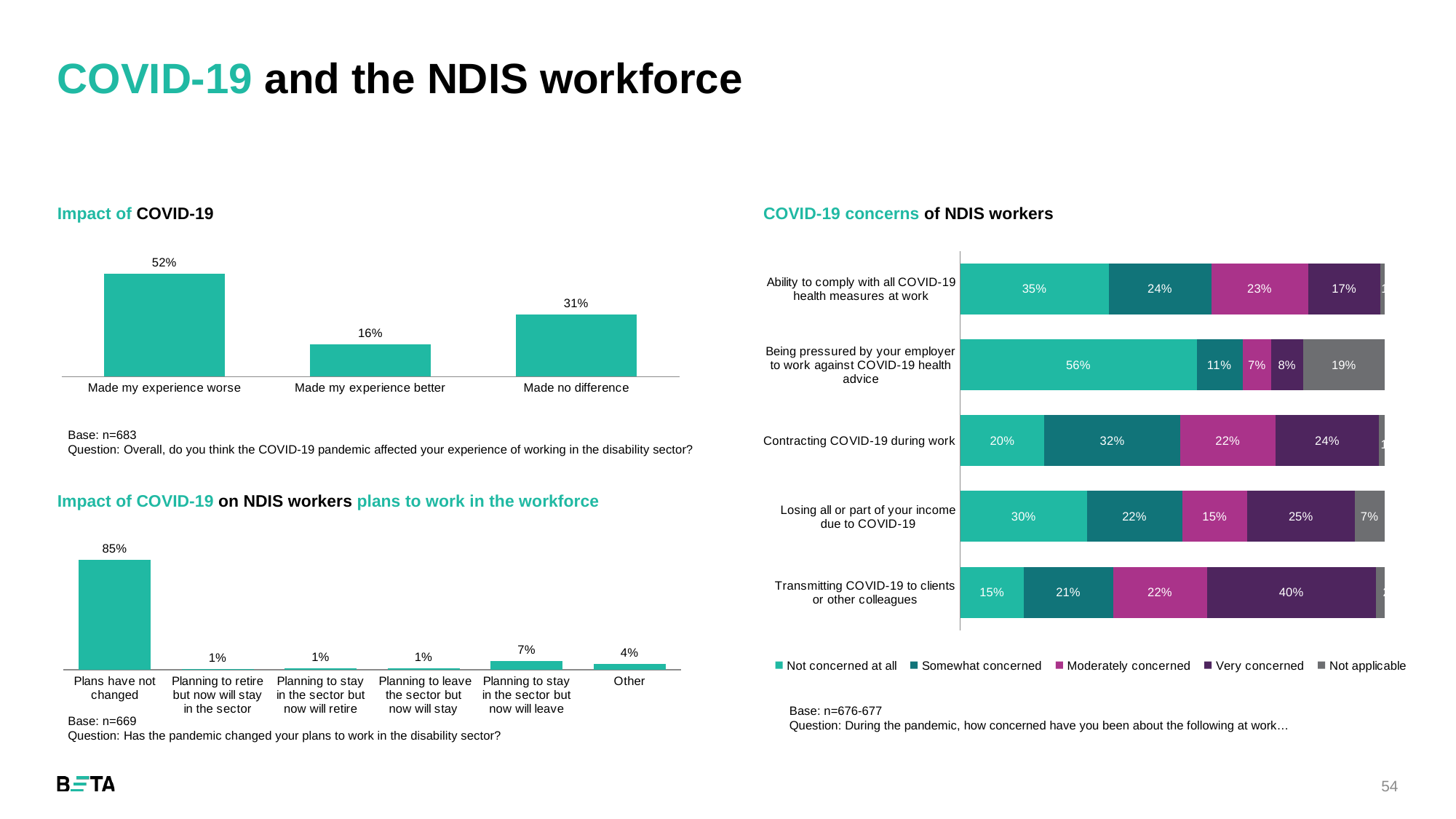
In the 'COVID-19 concerns of NDIS workers' chart, what is the difference between the 'Somewhat concerned' values for 'Contracting COVID-19 during work' and 'Losing all or part of your income due to COVID-19'? 10% In the 'COVID-19 concerns of NDIS workers' chart, what percentage were 'Not concerned at all' about being pressured by their employer to work against COVID-19 health advice? 56% In the 'Impact of COVID-19' chart, which category has the lowest value? Made my experience better In the 'Impact of COVID-19 on NDIS workers plans to work in the workforce' chart, how many categories are shown? 6 In the 'Impact of COVID-19' chart, what is the difference between 'Made my experience worse' and 'Made no difference'? 21% In the 'COVID-19 concerns of NDIS workers' chart, which concern has the highest 'Not concerned at all' value? Being pressured by your employer to work against COVID-19 health advice In the 'Impact of COVID-19 on NDIS workers plans to work in the workforce' chart, what percentage said their plans have not changed? 85% In the 'COVID-19 concerns of NDIS workers' chart, how many series does the legend list? 5 What type of chart is the 'Impact of COVID-19' chart? Bar chart In the 'Impact of COVID-19' chart, what percentage said the pandemic made their experience worse? 52% In the 'Impact of COVID-19 on NDIS workers plans to work in the workforce' chart, which is larger: 'Planning to stay in the sector but now will leave' or 'Other'? Planning to stay in the sector but now will leave In the 'COVID-19 concerns of NDIS workers' chart, what percentage were 'Very concerned' about transmitting COVID-19 to clients or other colleagues? 40%